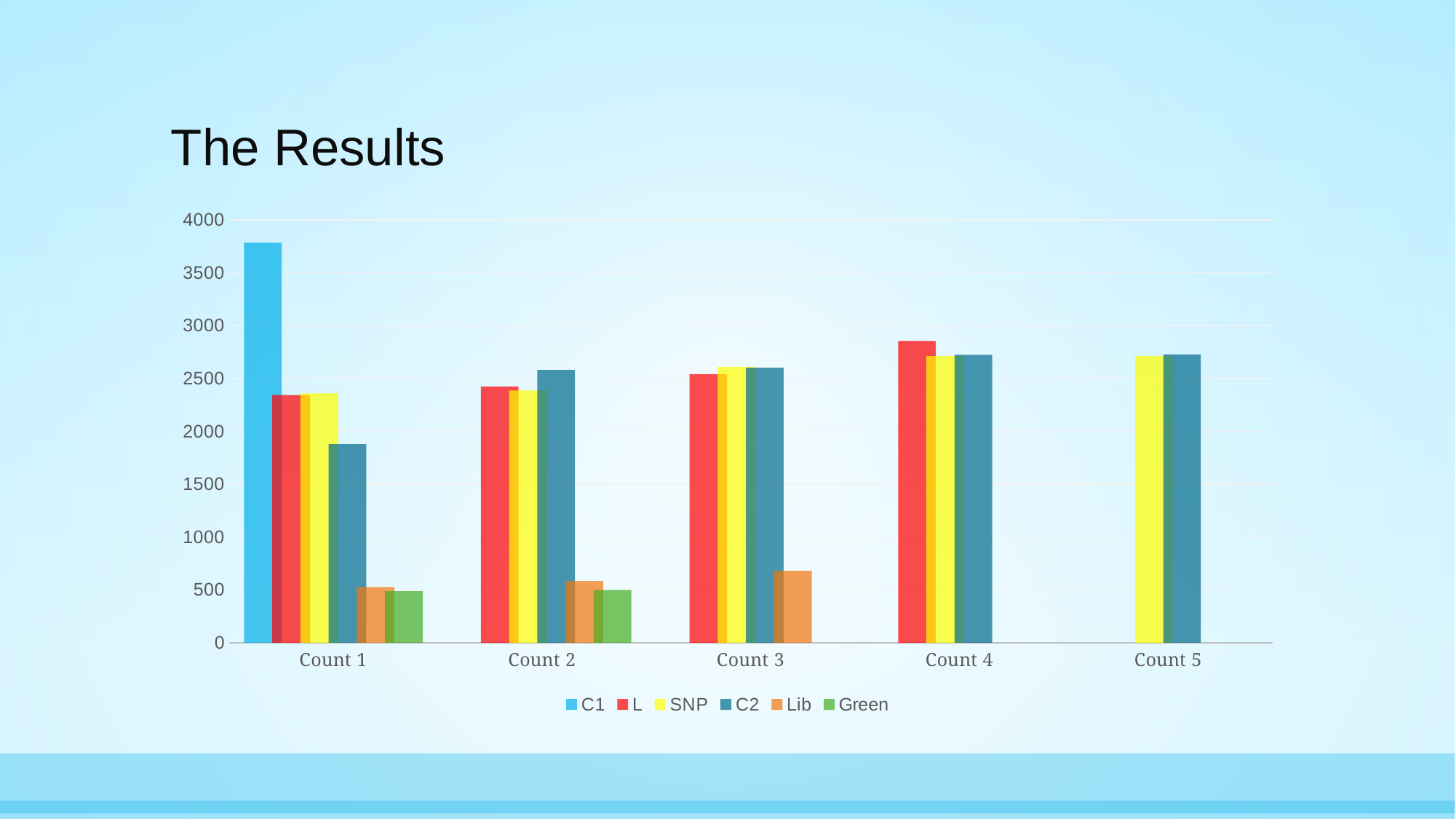
Is the value for C1 in Count 1 greater or less than 3500? greater What kind of chart is shown on the slide? bar chart Which series has the tallest bar in the whole chart? C1 Which series appears only in Count 1? C1 In Count 2, which is larger, the value for L or the value for C2? C2 How many series does the legend list? 6 Is the value for L in Count 4 greater or less than 3000? less In Count 1, which series has the highest value? C1 Is the value for Lib in Count 3 greater or less than 500? greater Does the value for L rise or fall from Count 1 to Count 4? rise How many categories are shown on the x axis? 5